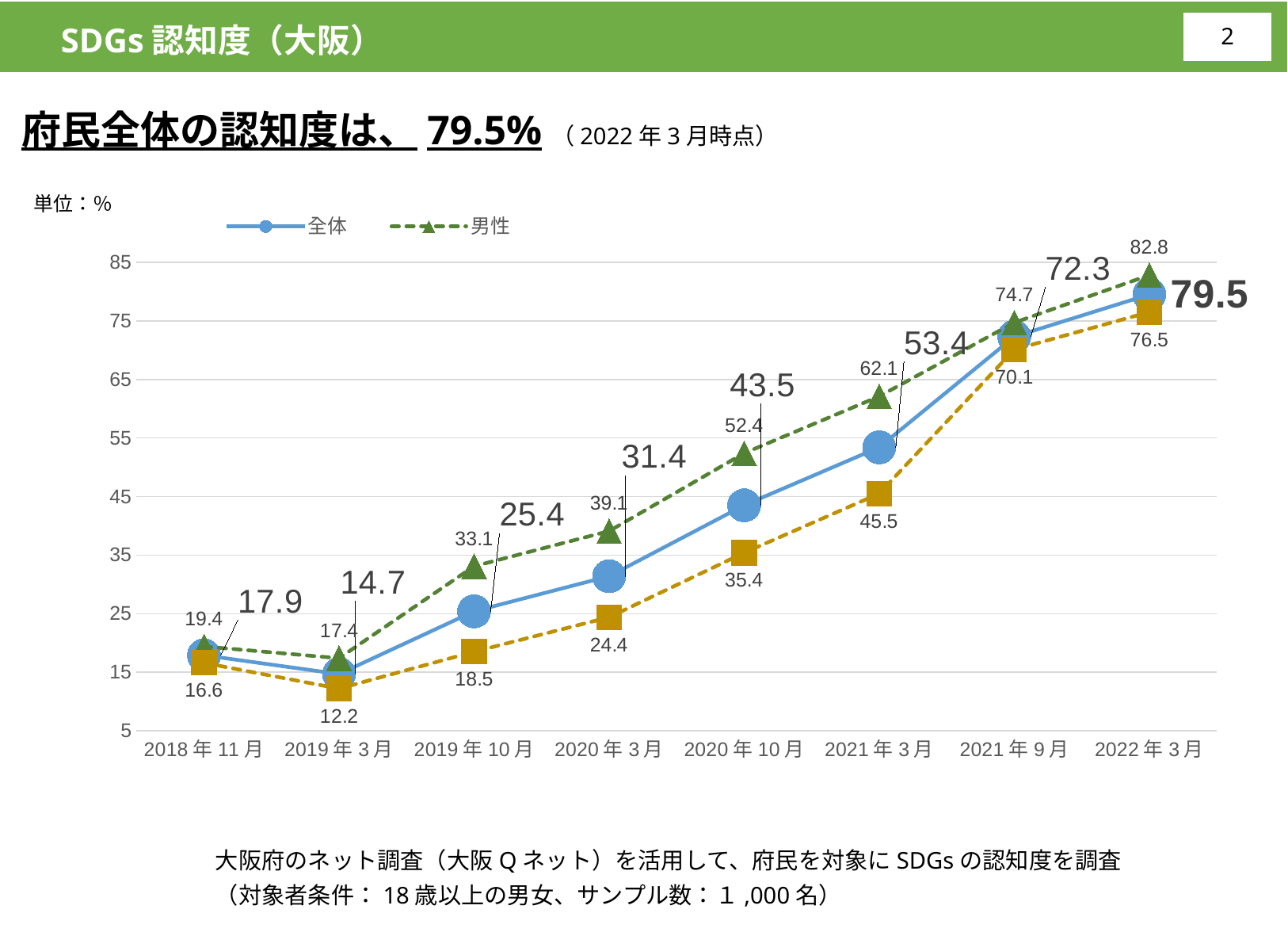
How much higher is the 男性 value than the 全体 value at 2022年3月? 3.3 Is the 全体 value at 2020年10月 greater or less than 45? less What is the value of the 全体 series at 2022年3月? 79.5 How many series does the legend list? 2 At 2021年3月, which is larger: the 全体 value or the 男性 value? 男性 At which time point is the 全体 series highest? 2022年3月 What is the value of the orange square-marker series at 2019年3月? 12.2 By how much did the 全体 value increase from 2018年11月 to 2022年3月? 61.6 At which time point is the 全体 series lowest? 2019年3月 What kind of chart is shown on the slide? line chart How many time points are plotted on the x axis? 8 What is the value of the 男性 series at 2020年10月? 52.4